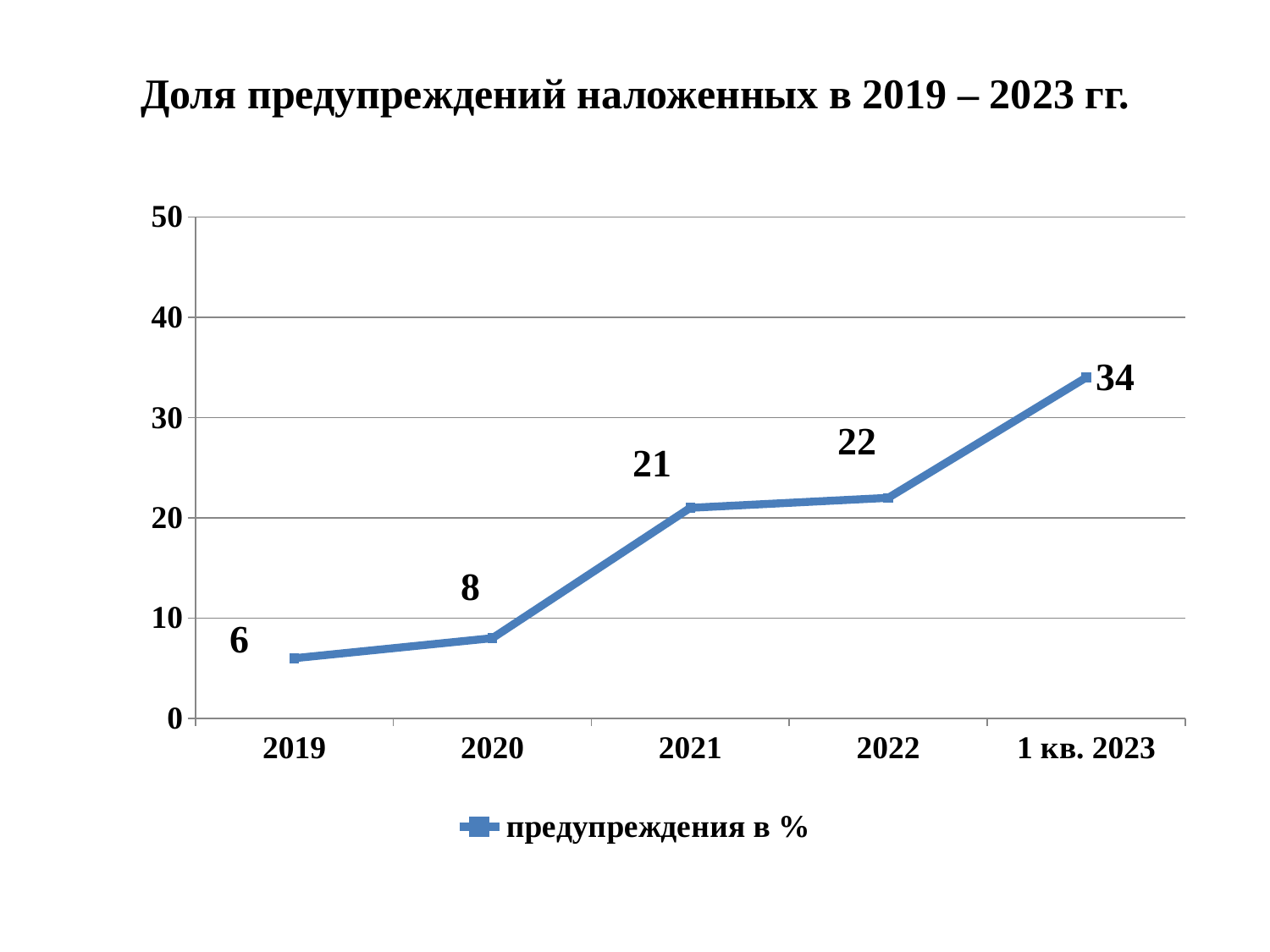
What is the difference between the values for 2021 and 2020? 13 Is the value for 2022 greater or less than 30? less Which is larger, the value for 2020 or the value for 2021? 2021 What is the value for 1 кв. 2023? 34 Do the values rise or fall from 2019 to 1 кв. 2023? rise What is the value for 2021? 21 How many data points are plotted on the chart? 5 Which category has the highest value? 1 кв. 2023 Which category has the lowest value? 2019 What is the value for 2019? 6 What is the difference between the values for 1 кв. 2023 and 2022? 12 What kind of chart is shown on the slide? line chart